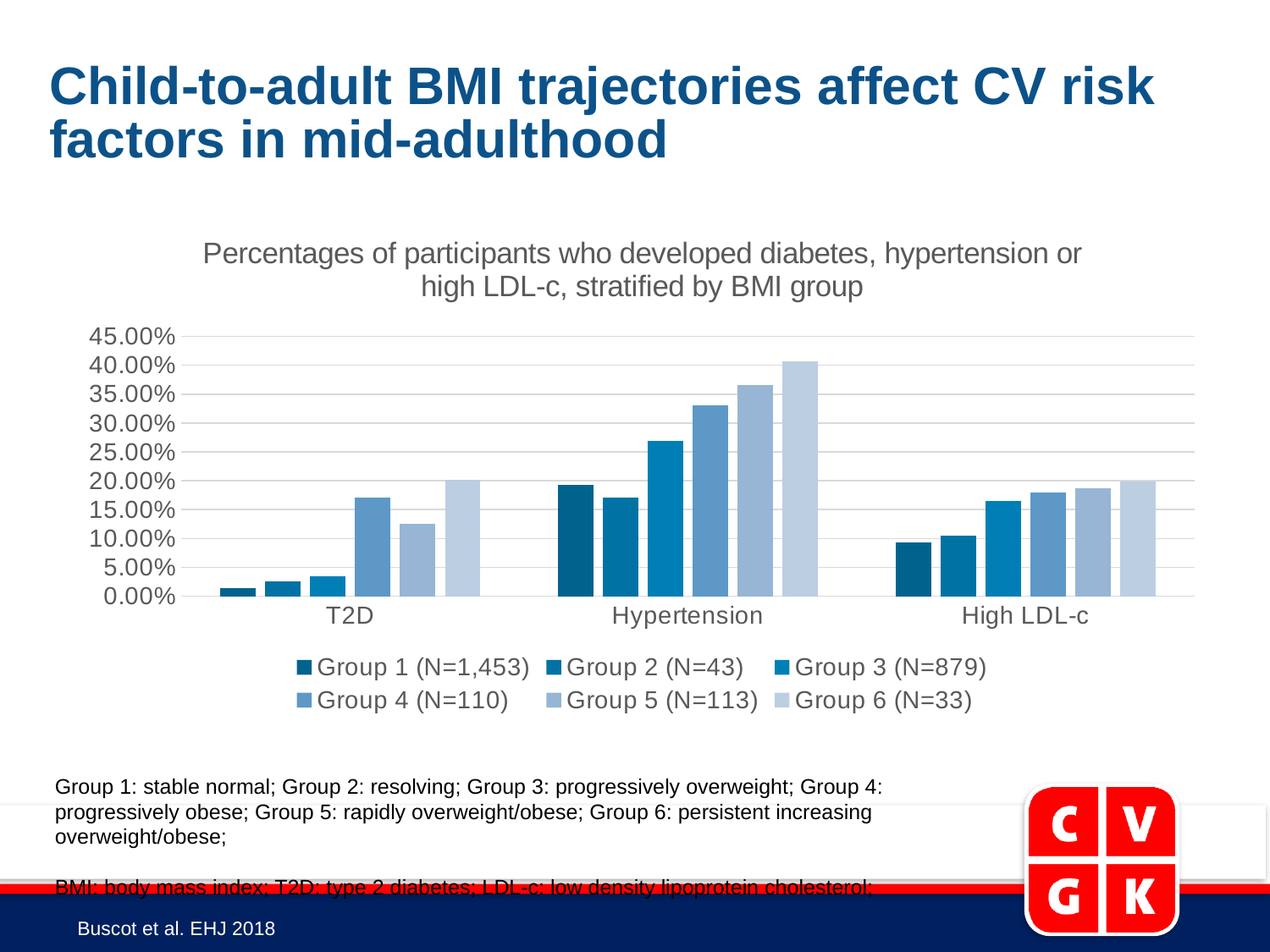
In which category is the Group 6 (N=33) bar the highest? Hypertension How many series does the legend list? 6 Is the value for Group 4 (N=110) in the Hypertension category greater or less than 30.00%? greater In the High LDL-c category, which is larger: Group 3 (N=879) or Group 6 (N=33)? Group 6 (N=33) What kind of chart is shown on the slide? Bar chart Is the value for Group 6 (N=33) in the Hypertension category greater or less than 35.00%? greater How many categories are shown on the x axis? 3 Which group has the lowest bar in the Hypertension category? Group 2 (N=43) What is the title of the chart? Percentages of participants who developed diabetes, hypertension or high LDL-c, stratified by BMI group Is the value for Group 1 (N=1,453) in the T2D category greater or less than 5.00%? less According to the legend, what is the N for Group 1? N=1,453 In the T2D category, which is larger: Group 4 (N=110) or Group 5 (N=113)? Group 4 (N=110)